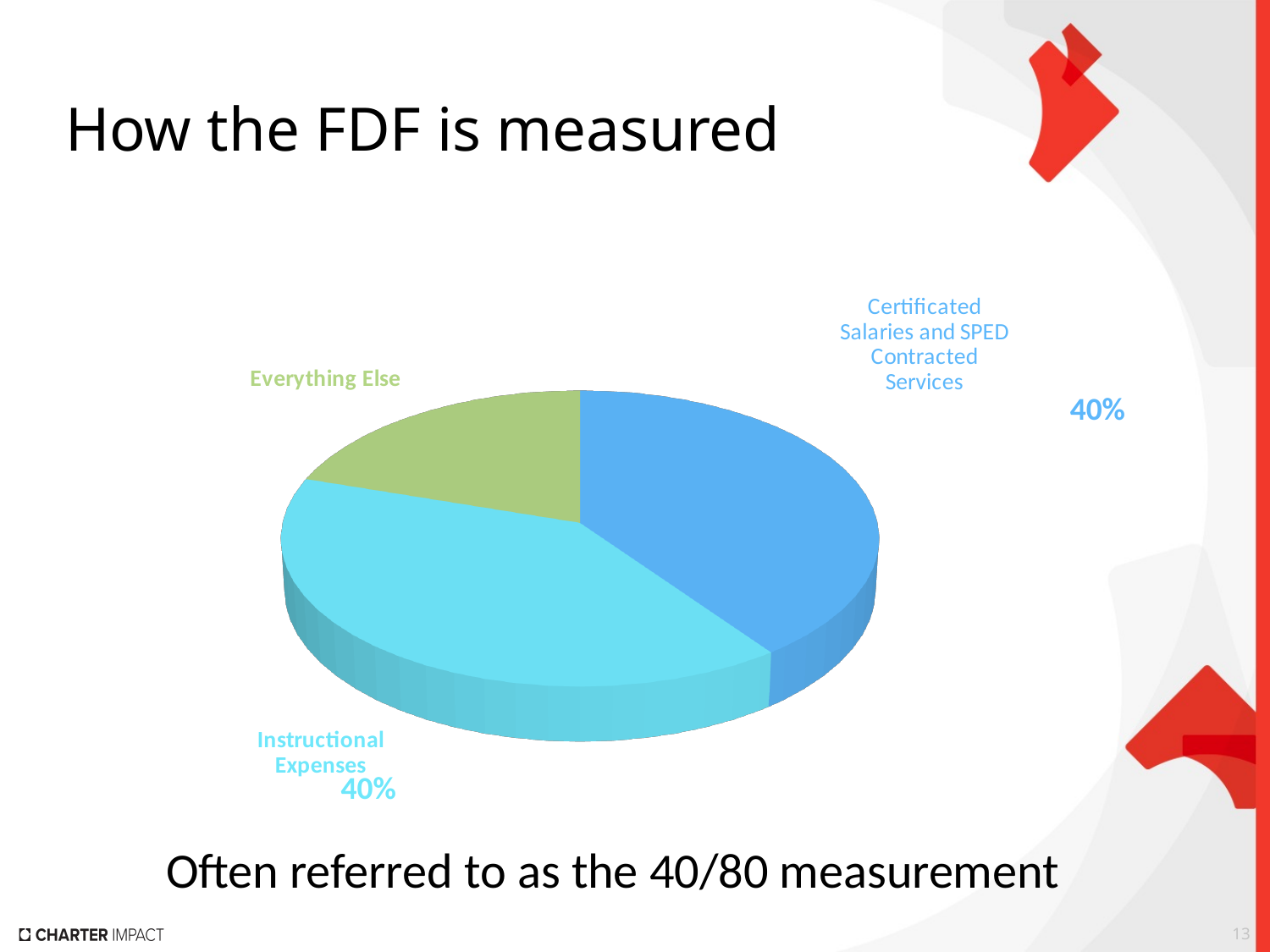
What percentage is shown for Instructional Expenses? 40% What colour is the Everything Else slice of the pie chart? green What is the title of the slide containing the pie chart? How the FDF is measured What kind of chart is shown on the slide? pie chart Which slice is larger, Everything Else or Certificated Salaries and SPED Contracted Services? Certificated Salaries and SPED Contracted Services What percentage is shown for Certificated Salaries and SPED Contracted Services? 40% Which slice is larger, Everything Else or Instructional Expenses? Instructional Expenses Which slice of the pie chart is the smallest? Everything Else How many slices does the pie chart have? 3 What is the difference between the percentage for Certificated Salaries and SPED Contracted Services and the percentage for Instructional Expenses? 0%